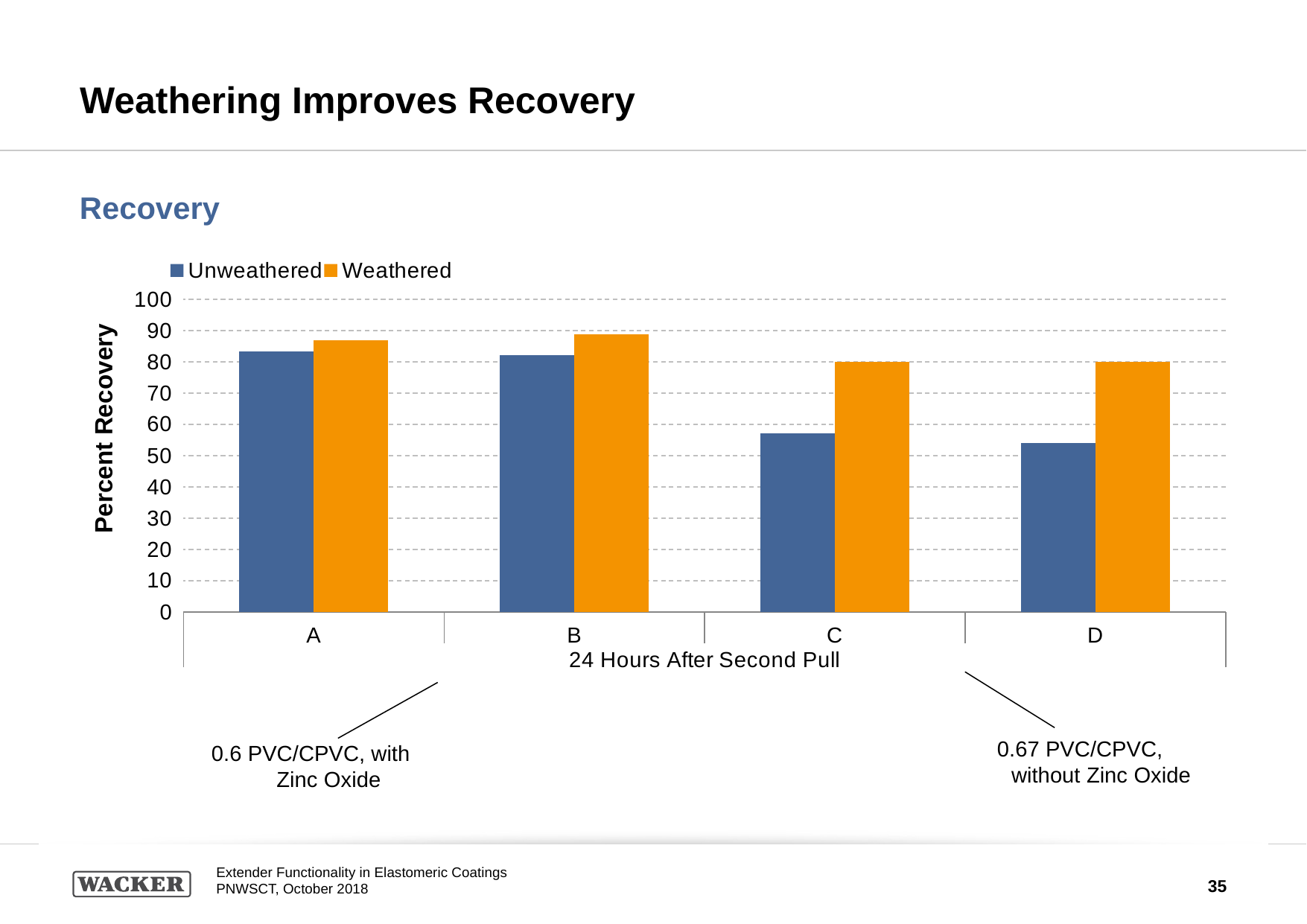
Do the Unweathered values rise or fall from A to D? fall Is the Unweathered value for C greater or less than 60? less For category D, which series has the larger value, Unweathered or Weathered? Weathered What is the title of the y axis? Percent Recovery How many series does the legend list? 2 Is the Unweathered value for D greater or less than 60? less How many categories are shown on the x axis? 4 Which is larger, the Unweathered value for A or the Unweathered value for C? A What kind of chart is shown on the slide? bar chart Is the Unweathered value for A greater or less than 80? greater Which series is shown in orange? Weathered